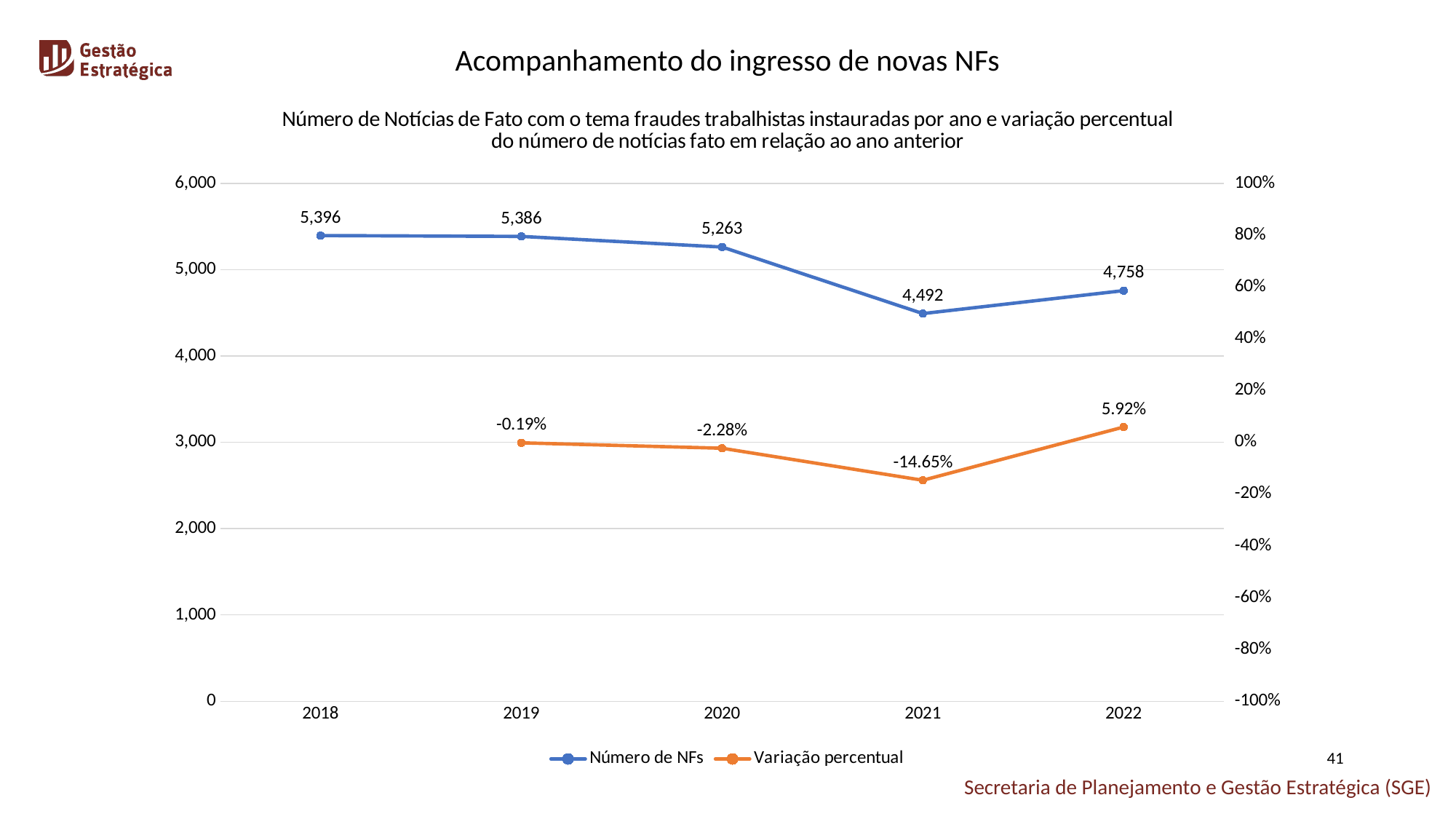
What is the difference in Número de NFs between 2020 and 2021? 771 How many years are shown on the x axis? 5 What is the value of Número de NFs for 2018? 5,396 Which year has the highest Número de NFs? 2018 What is the Variação percentual for 2022? 5.92% What kind of chart is shown on the slide? Line chart What is the Variação percentual for 2021? -14.65% Which year has the lowest Número de NFs? 2021 What is the value of Número de NFs for 2021? 4,492 Which is larger, the Número de NFs for 2020 or for 2022? 2020 Does the Número de NFs series rise or fall from 2018 to 2021? Fall How many series does the legend list? 2